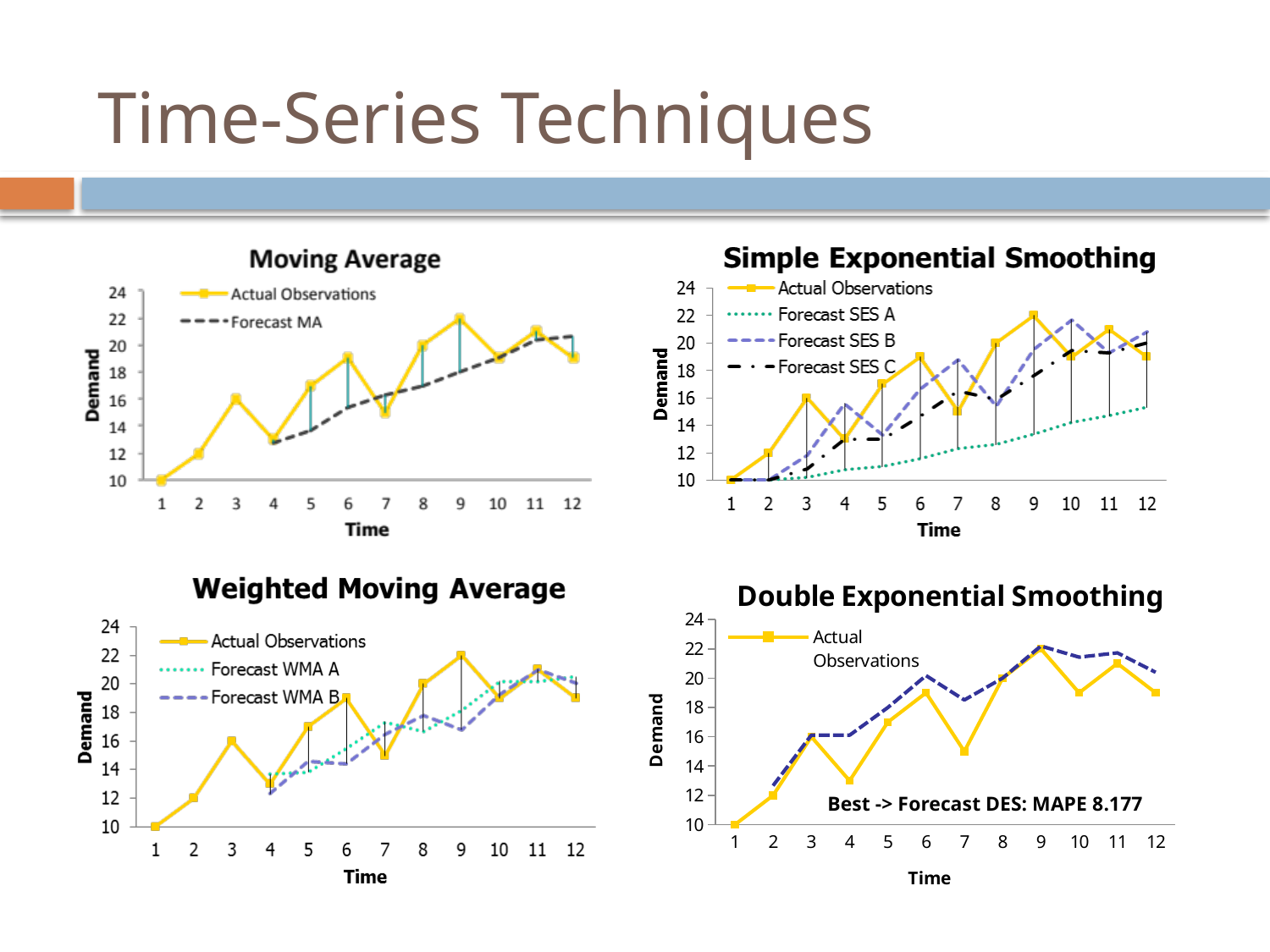
What kind of chart is the Moving Average chart? line chart In the Weighted Moving Average chart, how many series does the legend list? 3 In the Weighted Moving Average chart, at which time is the Actual Observations value lowest? 1 In the Double Exponential Smoothing chart, which is larger, the Actual Observations value at time 9 or at time 4? time 9 In the Double Exponential Smoothing chart, what is the Actual Observations value at time 9? 22 In the Moving Average chart, do the Actual Observations generally rise or fall from time 1 to time 12? rise In the Double Exponential Smoothing chart, what MAPE value is stated for the best forecast? 8.177 In the Moving Average chart, what is the Actual Observations value at time 1? 10 In the Moving Average chart, is the Actual Observations value at time 7 greater or less than 16? less In the Moving Average chart, how many time periods are shown on the x axis? 12 In the Simple Exponential Smoothing chart, at which time is the Actual Observations value highest? 9 In the Simple Exponential Smoothing chart, how many series does the legend list? 4